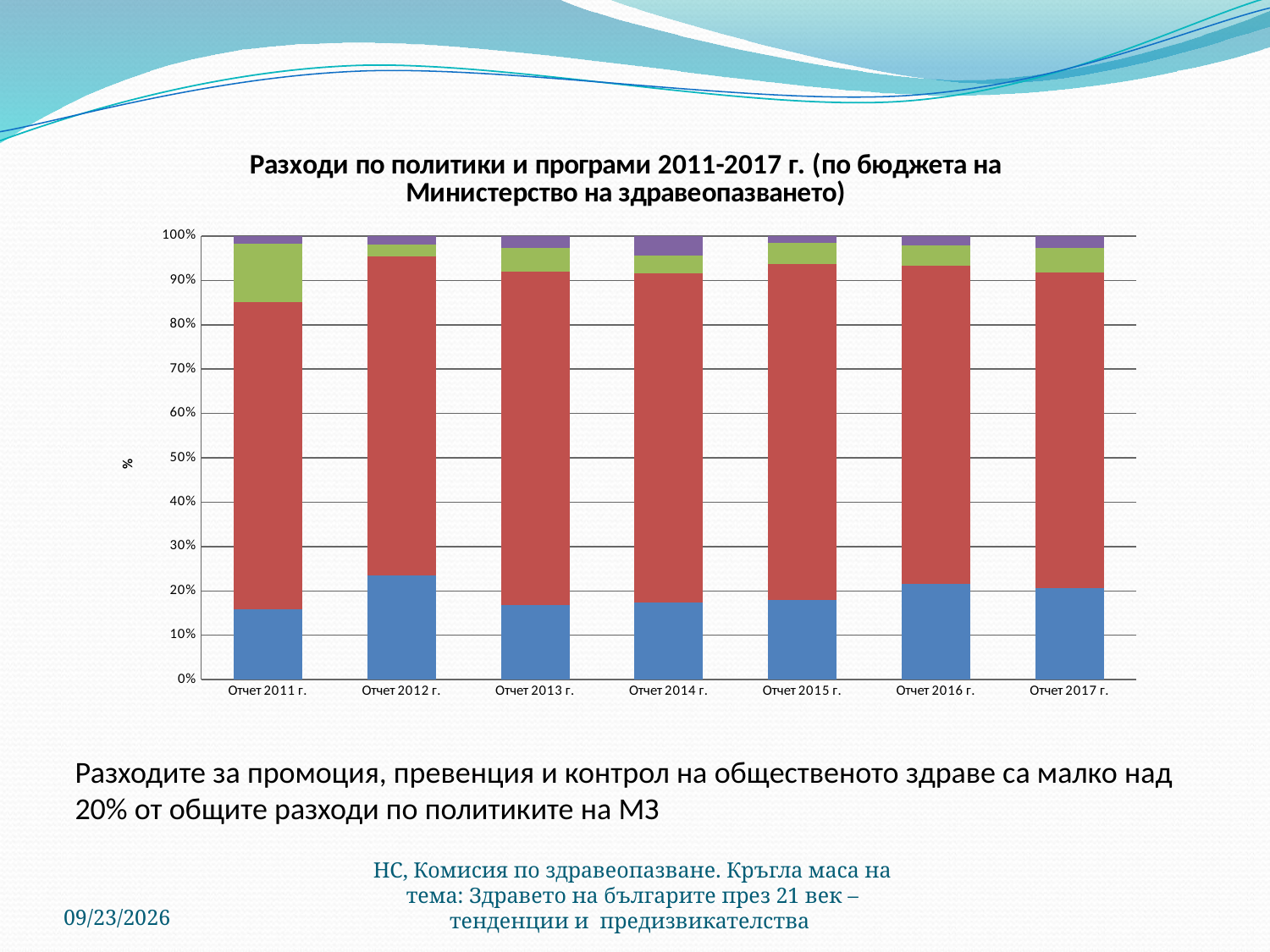
What kind of chart is shown on the slide? Stacked bar chart Is the blue (bottom) segment larger for Отчет 2012 г. or for Отчет 2011 г.? Отчет 2012 г. What is the title of the chart? Разходи по политики и програми 2011-2017 г. (по бюджета на Министерство на здравеопазването) Which category has the largest green segment? Отчет 2011 г. Is the value of the blue (bottom) segment for Отчет 2011 г. greater or less than 20%? less What is the label of the first category on the x axis? Отчет 2011 г. Is the value of the blue (bottom) segment for Отчет 2013 г. greater or less than 20%? less How many categories (reports) are shown along the x axis? 7 What is the total height of each stacked bar on the y axis? 100% Is the value of the blue (bottom) segment for Отчет 2016 г. greater or less than 20%? greater Which category has the largest blue (bottom) segment? Отчет 2012 г.